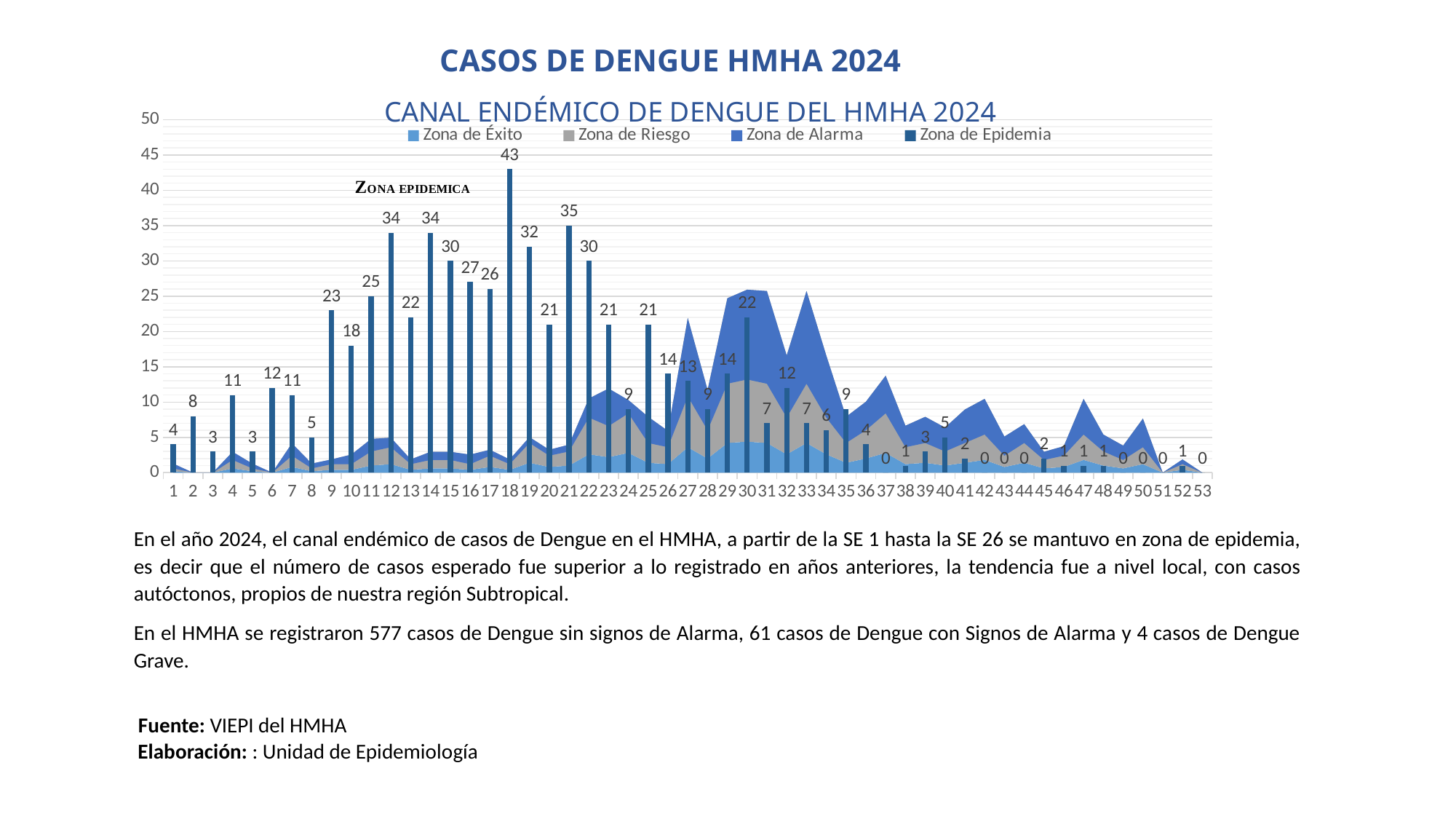
What is the value of the bar for week 12? 34 What is the value of the bar for week 30? 22 How many weeks are shown on the x axis of the chart? 53 What is the difference between the bar values for week 18 and week 21? 8 What is the title of the chart? CANAL ENDÉMICO DE DENGUE DEL HMHA 2024 What is the value of the bar for week 18 in the CANAL ENDÉMICO DE DENGUE DEL HMHA 2024 chart? 43 Do the bar values generally rise or fall from week 21 to week 53? fall Is the bar value for week 19 greater or less than 30? greater Which has a larger bar value, week 9 or week 10? Week 9 Which week has the highest bar value? 18 Which legend entry is listed first? Zona de Éxito How many series does the legend list? 4